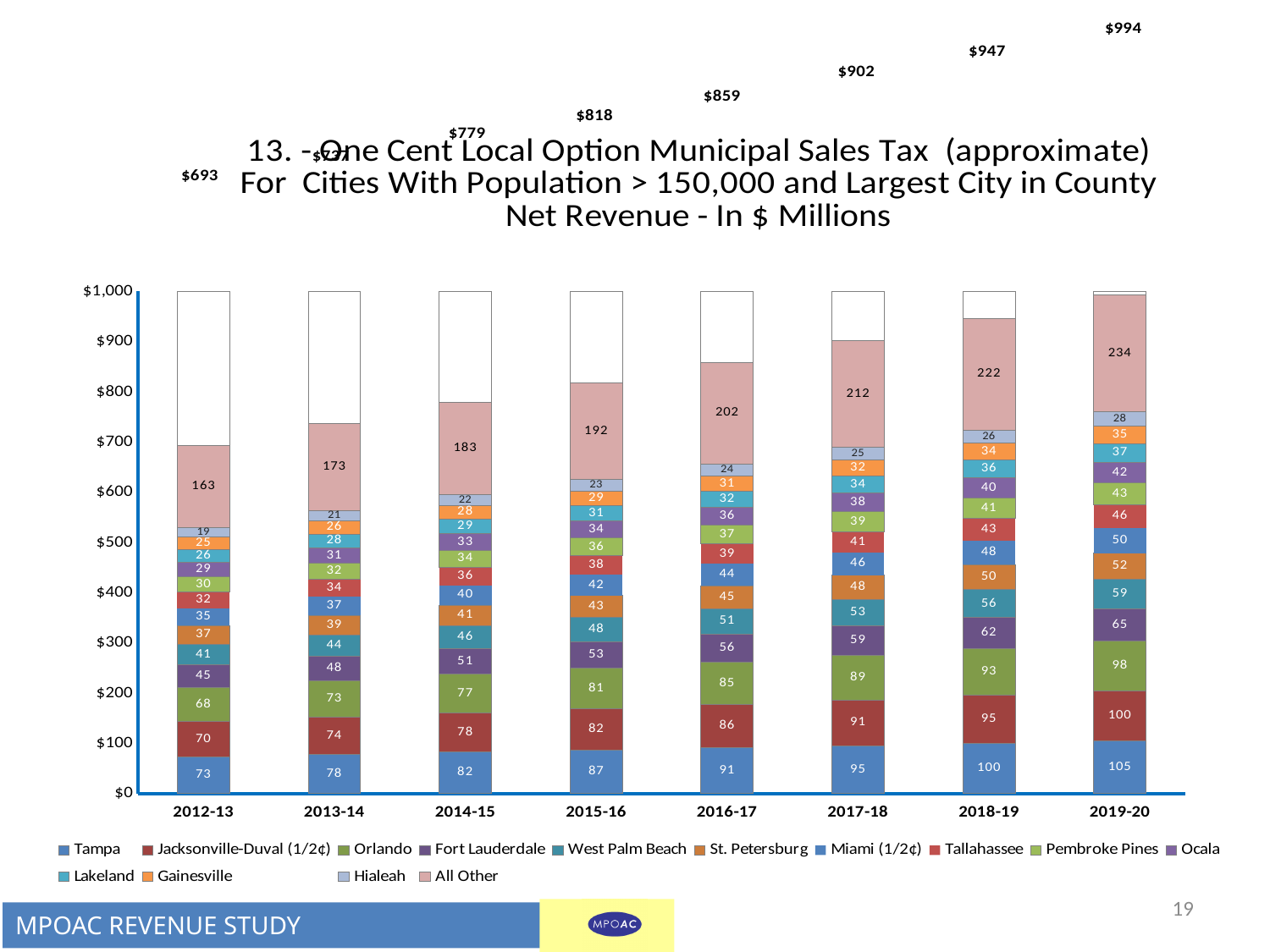
What is the value for Tampa in 2019-20? 105 How many fiscal years are shown on the x axis? 8 Which year has the lowest total net revenue? 2012-13 Do the total net revenues rise or fall from 2012-13 to 2019-20? Rise What kind of chart is shown on the slide? Stacked bar chart Which is larger in 2016-17, Jacksonville-Duval (1/2¢) or Orlando? Jacksonville-Duval (1/2¢) What is the value for Hialeah in 2016-17? 24 What is the value for All Other in 2012-13? 163 What is the difference between the Tampa value in 2019-20 and in 2012-13? 32 Which year has the highest total net revenue? 2019-20 What is the total net revenue for 2015-16? $818 How many series does the legend list? 14